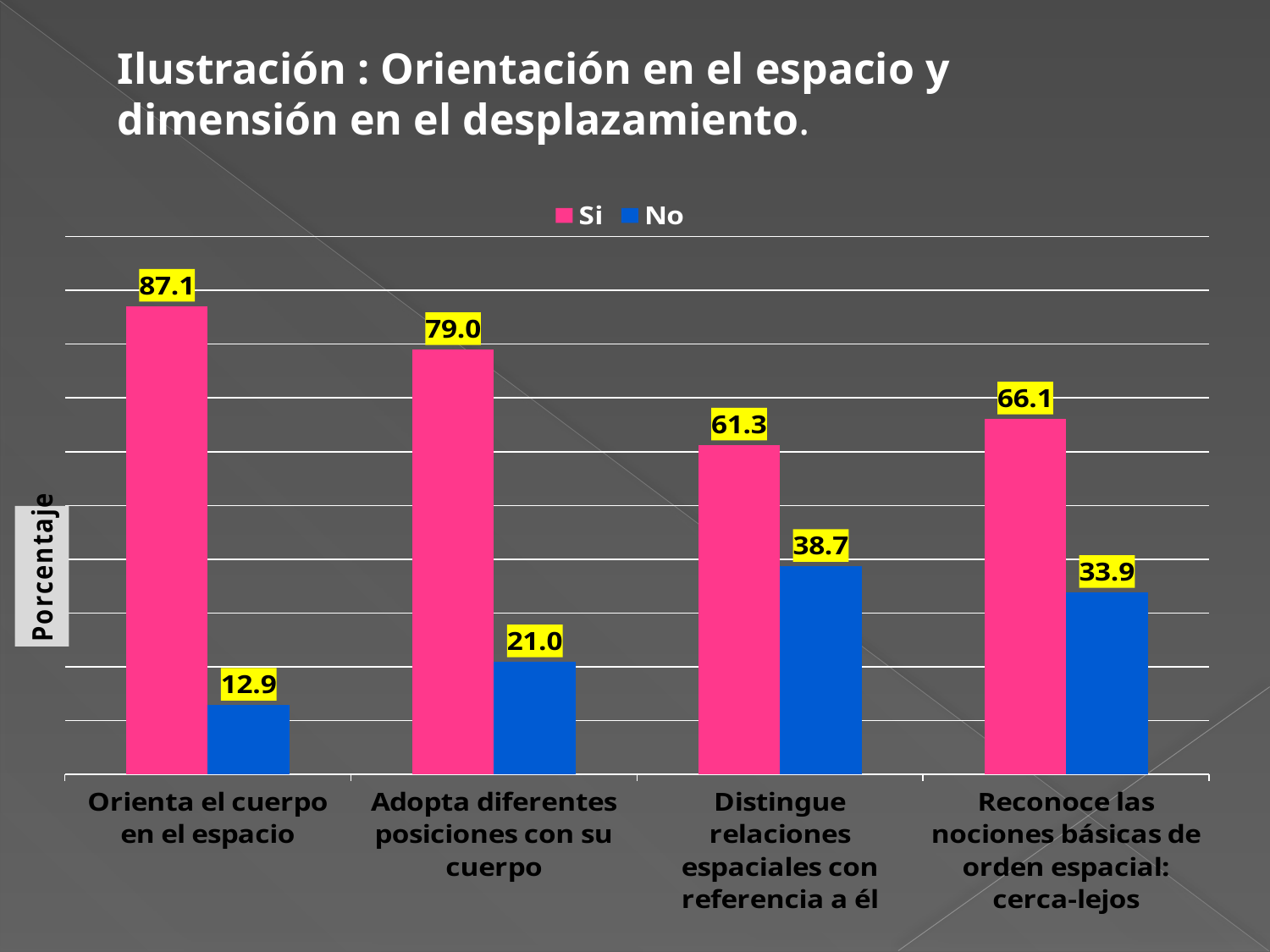
How many series does the legend list? 2 What is the 'No' value for 'Reconoce las nociones básicas de orden espacial: cerca-lejos'? 33.9 What is the difference between the 'Si' and 'No' values for 'Distingue relaciones espaciales con referencia a él'? 22.6 What is the label of the vertical axis? Porcentaje What is the 'No' value for 'Adopta diferentes posiciones con su cuerpo'? 21.0 What is the 'Si' value for 'Distingue relaciones espaciales con referencia a él'? 61.3 Which is larger: the 'No' value for 'Distingue relaciones espaciales con referencia a él' or the 'No' value for 'Reconoce las nociones básicas de orden espacial: cerca-lejos'? Distingue relaciones espaciales con referencia a él How many categories are shown on the x axis? 4 Which category has the highest 'Si' value? Orienta el cuerpo en el espacio What kind of chart is shown on the slide? Bar chart What is the 'Si' value for 'Orienta el cuerpo en el espacio'? 87.1 Which category has the lowest 'No' value? Orienta el cuerpo en el espacio